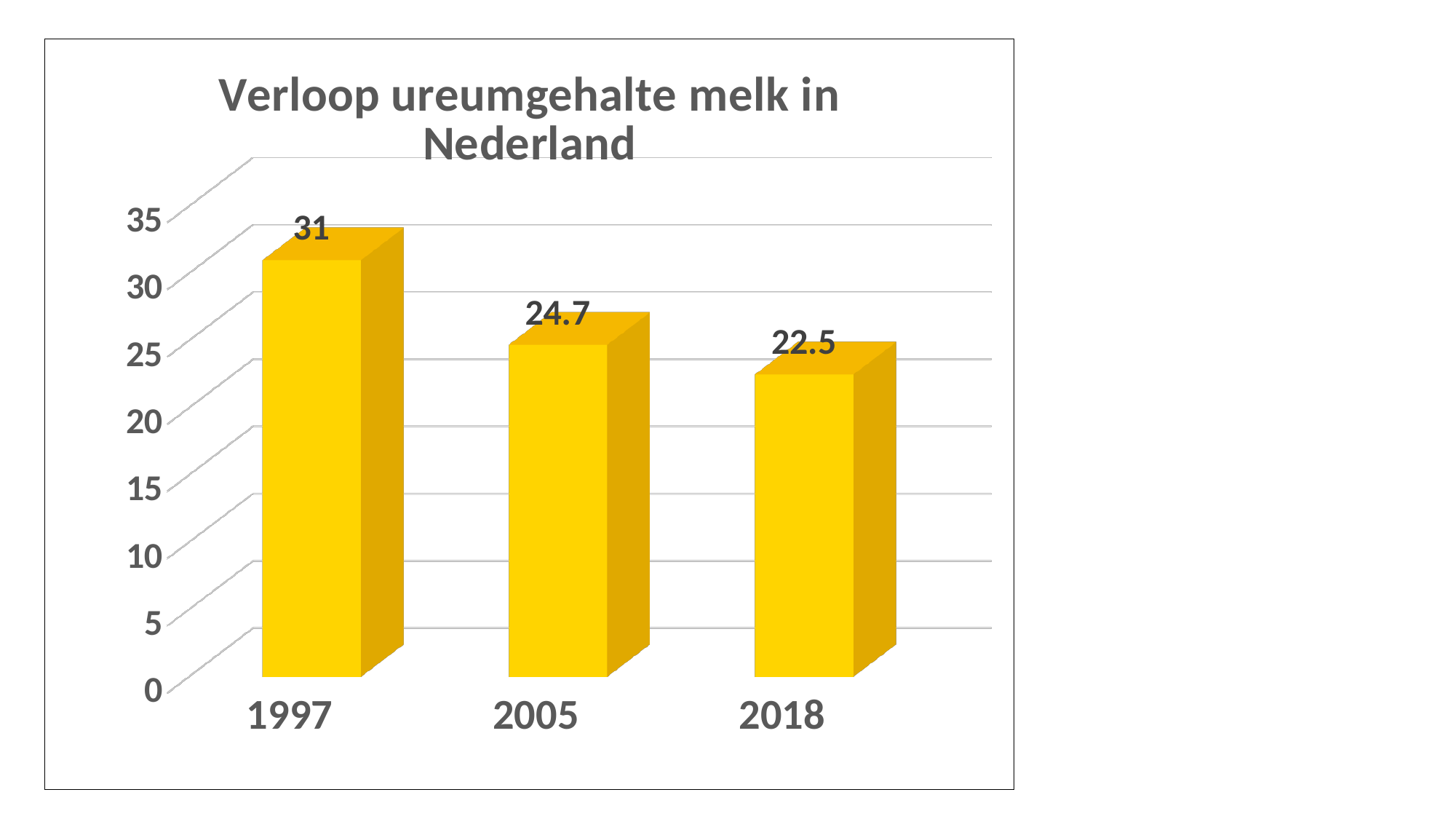
Which year has the highest value? 1997 Do the values rise or fall from 1997 to 2018? fall How many years are shown on the x axis? 3 What is the difference between the values for 1997 and 2018? 8.5 What is the value for 1997? 31 What is the difference between the values for 2005 and 2018? 2.2 Is the value for 1997 greater or less than 30? greater What is the value for 2005? 24.7 Which year has the lowest value? 2018 What is the value for 2018? 22.5 What kind of chart is this? bar chart Which is larger, the value for 2005 or the value for 2018? 2005